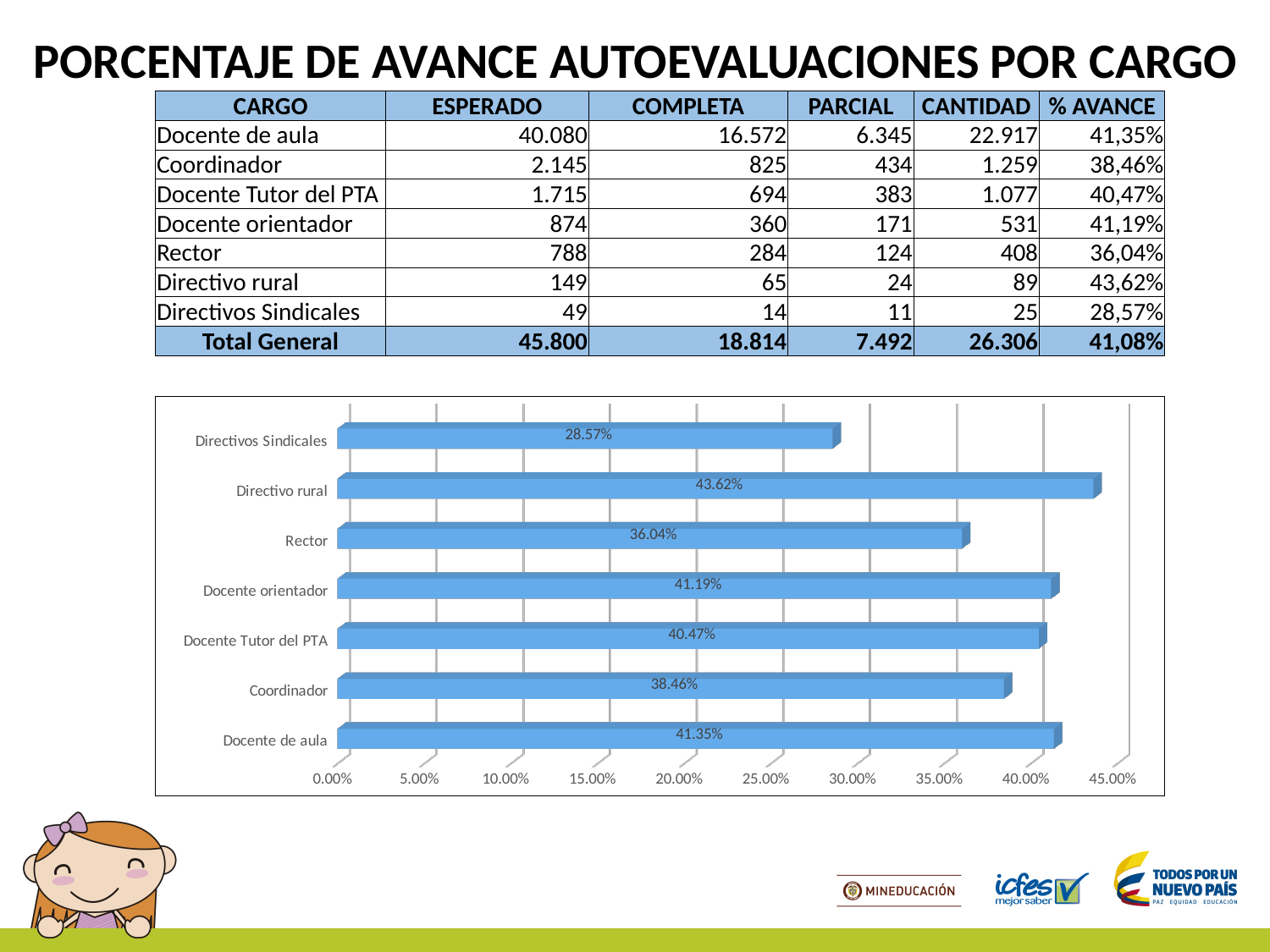
What type of chart is shown on the slide? bar chart What is the value shown for Rector in the bar chart? 36.04% What is the maximum value shown on the x axis of the bar chart? 45.00% What is the value shown for Directivo rural in the bar chart? 43.62% What is the value shown for Docente Tutor del PTA in the bar chart? 40.47% What is the value shown for Coordinador in the bar chart? 38.46% Which category has the highest value in the bar chart? Directivo rural How many categories (cargos) are plotted in the bar chart? 7 Is the value for Directivos Sindicales in the bar chart greater or less than 30.00%? less Which category has the lowest value in the bar chart? Directivos Sindicales What is the difference between the values for Directivo rural and Directivos Sindicales in the bar chart? 15.05% Which has a larger value in the bar chart, Rector or Coordinador? Coordinador